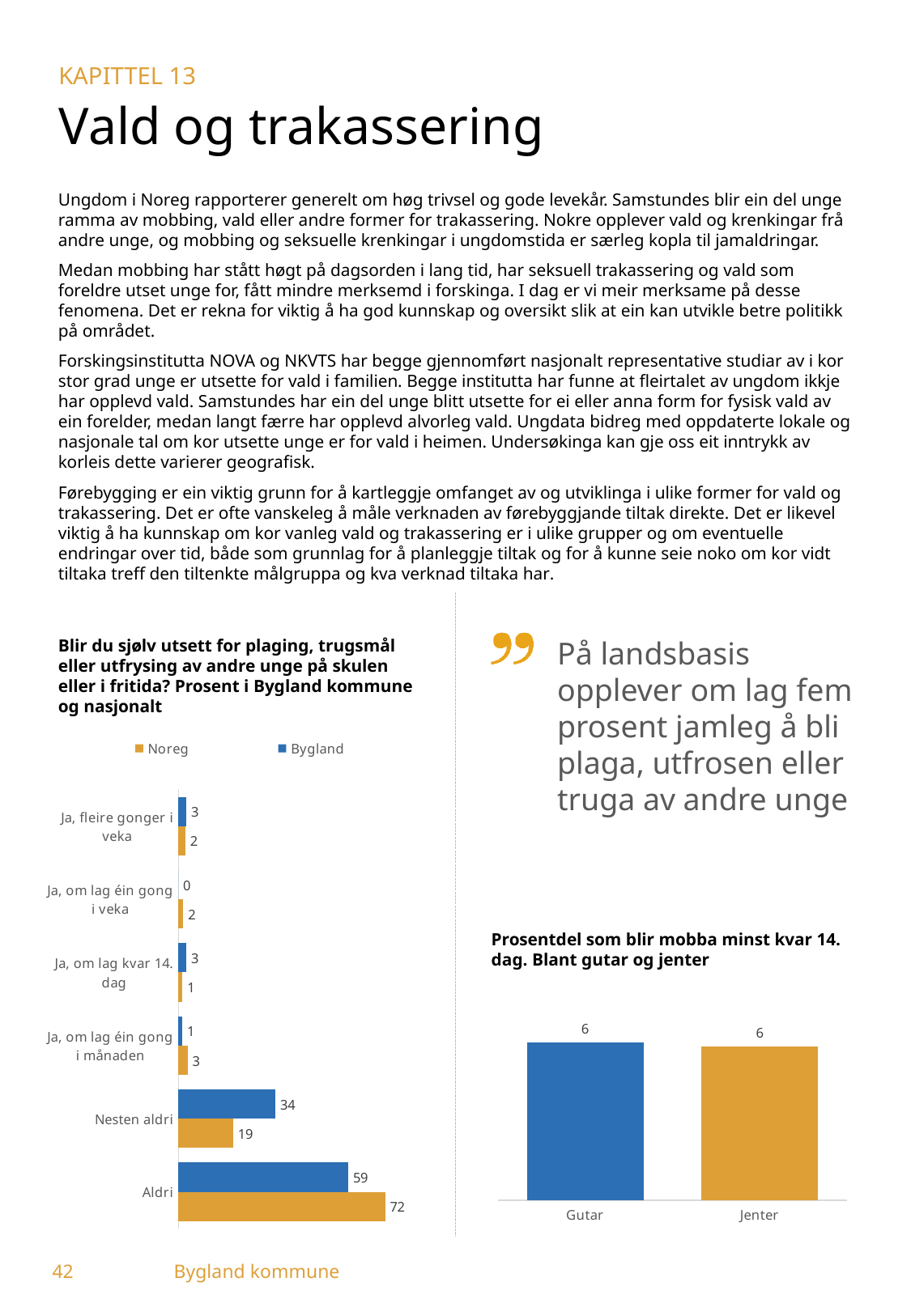
What kind of chart is 'Blir du sjølv utsett for plaging, trugsmål eller utfrysing av andre unge på skulen eller i fritida?'? Bar chart In the chart 'Blir du sjølv utsett for plaging, trugsmål eller utfrysing av andre unge på skulen eller i fritida?', which colour represents Noreg? Orange In the chart 'Blir du sjølv utsett for plaging, trugsmål eller utfrysing av andre unge på skulen eller i fritida?', how many categories are shown? 6 In the chart 'Blir du sjølv utsett for plaging, trugsmål eller utfrysing av andre unge på skulen eller i fritida?', how many series does the legend list? 2 In the chart 'Blir du sjølv utsett for plaging, trugsmål eller utfrysing av andre unge på skulen eller i fritida?', which is larger for 'Nesten aldri': Bygland or Noreg? Bygland In the chart 'Blir du sjølv utsett for plaging, trugsmål eller utfrysing av andre unge på skulen eller i fritida?', what is the value for Noreg in the category 'Nesten aldri'? 19 In the chart 'Blir du sjølv utsett for plaging, trugsmål eller utfrysing av andre unge på skulen eller i fritida?', what is the value for Bygland in the category 'Aldri'? 59 In the chart 'Blir du sjølv utsett for plaging, trugsmål eller utfrysing av andre unge på skulen eller i fritida?', what is the value for Bygland in the category 'Ja, om lag éin gong i veka'? 0 In the chart 'Prosentdel som blir mobba minst kvar 14. dag. Blant gutar og jenter', what is the value for Jenter? 6 In the chart 'Blir du sjølv utsett for plaging, trugsmål eller utfrysing av andre unge på skulen eller i fritida?', which category has the highest value for Noreg? Aldri In the chart 'Prosentdel som blir mobba minst kvar 14. dag. Blant gutar og jenter', what is the difference between the values for Gutar and Jenter? 0 In the chart 'Blir du sjølv utsett for plaging, trugsmål eller utfrysing av andre unge på skulen eller i fritida?', what is the difference between the Noreg and Bygland values for 'Aldri'? 13